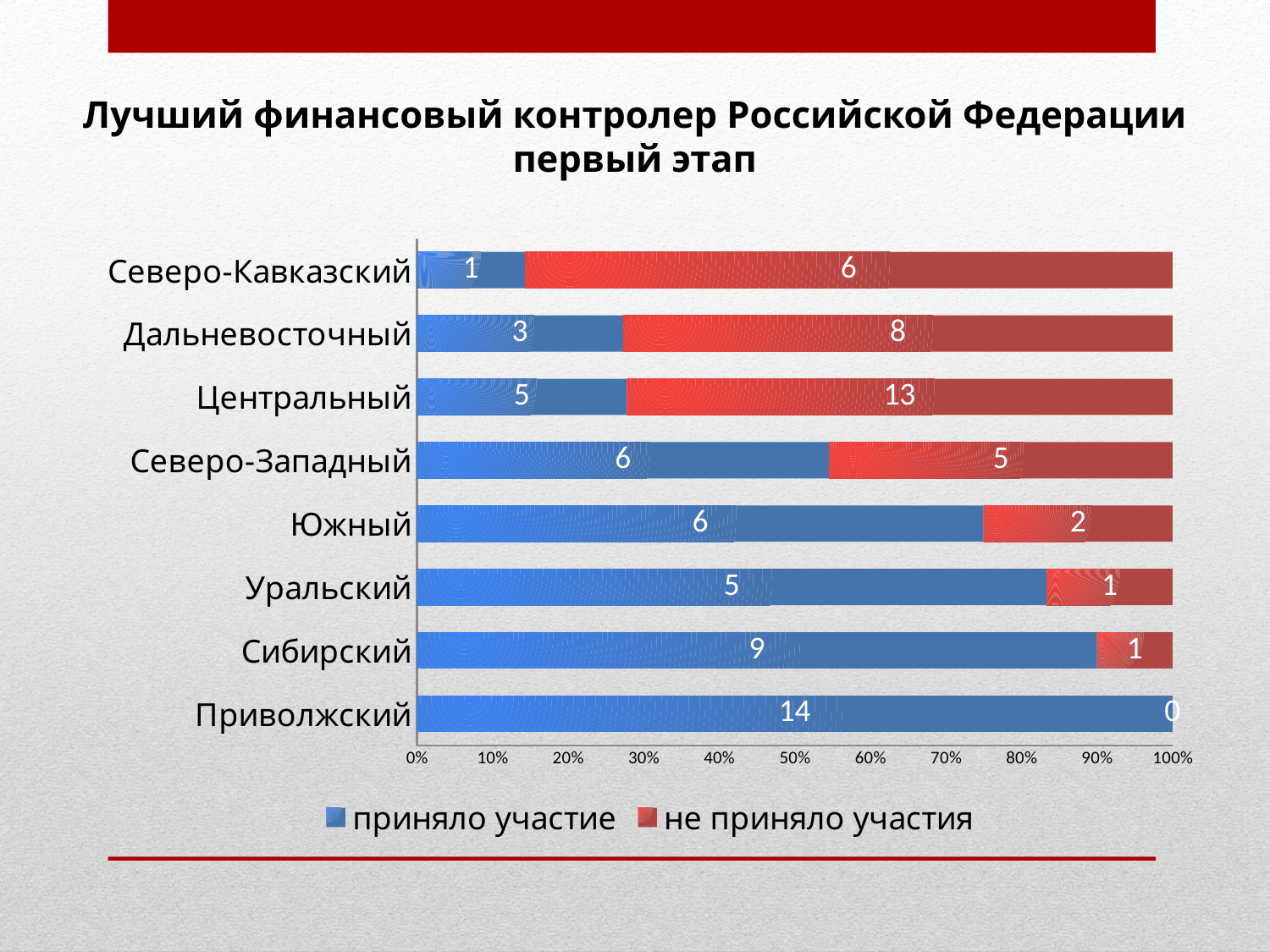
What is the difference between the "не приняло участия" values for Центральный and Дальневосточный? 5 Which is larger for Северо-Западный: "приняло участие" or "не приняло участия"? приняло участие How many series does the legend list? 2 What value is shown for "приняло участие" for Приволжский? 14 Which colour represents "не приняло участия" in the chart? Red What value is shown for "приняло участие" for Дальневосточный? 3 How many regions are shown on the chart? 8 What value is shown for "не приняло участия" for Центральный? 13 Which region has the highest value for "приняло участие"? Приволжский Which region has the lowest value for "приняло участие"? Северо-Кавказский What kind of chart is shown on the slide? Stacked bar chart What is the total of the two values for Центральный? 18